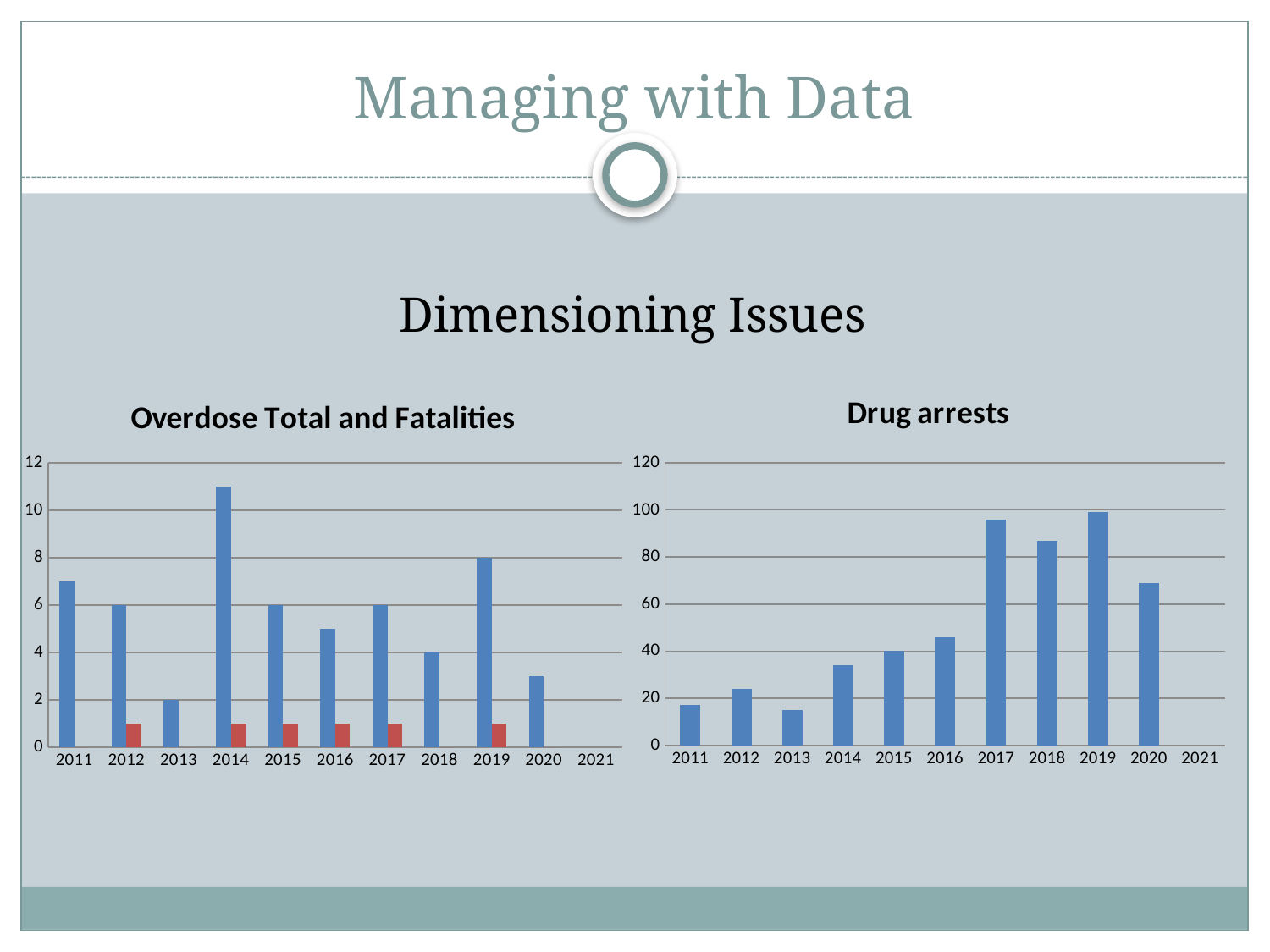
In the "Overdose Total and Fatalities" chart, which year has the shortest blue bar? 2013 In the "Overdose Total and Fatalities" chart, which year has the tallest blue bar? 2014 In the "Drug arrests" chart, which is larger, the value for 2018 or the value for 2016? 2018 In the "Drug arrests" chart, what is the value for 2015? 40 In the "Overdose Total and Fatalities" chart, what is the value of the blue bar for 2013? 2 What kind of chart is the "Drug arrests" chart? bar chart In the "Drug arrests" chart, how many years are labeled on the x axis? 11 In the "Drug arrests" chart, is the value for 2011 greater or less than 20? less In the "Drug arrests" chart, is the value for 2017 greater or less than 80? greater In the "Overdose Total and Fatalities" chart, is the blue bar for 2014 greater or less than 10? greater In the "Overdose Total and Fatalities" chart, what is the difference between the blue bars for 2019 and 2013? 6 In the "Overdose Total and Fatalities" chart, what is the value of the blue bar for 2019? 8